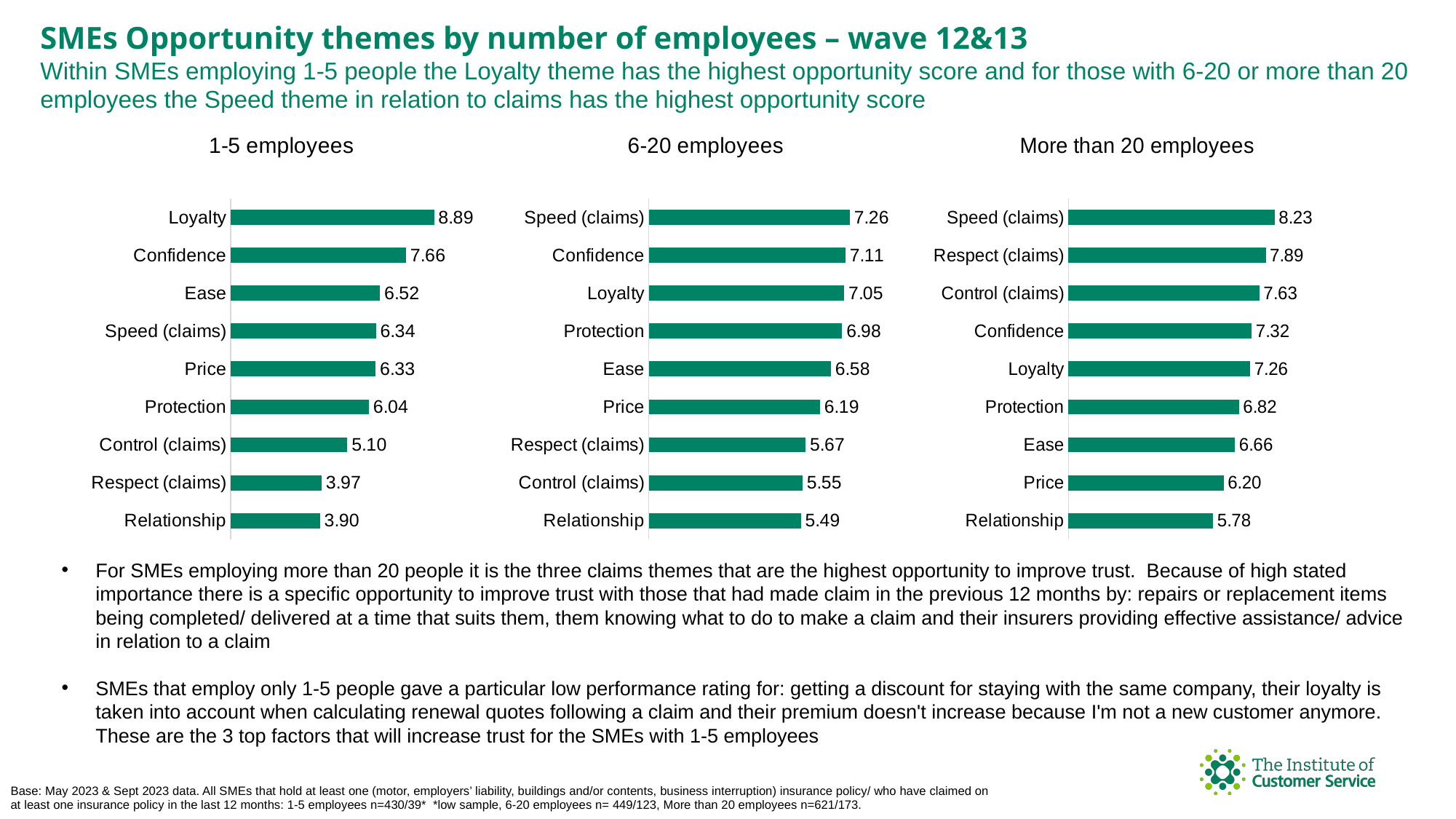
What type of chart is used for the 'More than 20 employees' data? Bar chart In the '6-20 employees' chart, which theme has the highest value? Speed (claims) How many themes are shown in the '1-5 employees' chart? 9 In the '1-5 employees' chart, which is larger, Ease or Protection? Ease In the 'More than 20 employees' chart, which theme has the lowest value? Relationship In the '6-20 employees' chart, which is larger, Price or Respect (claims)? Price In the 'More than 20 employees' chart, what is the value for Respect (claims)? 7.89 In the '1-5 employees' chart, what is the value for Loyalty? 8.89 In the 'More than 20 employees' chart, what is the difference between Speed (claims) and Relationship? 2.45 In the '6-20 employees' chart, what is the value for Protection? 6.98 In the '1-5 employees' chart, what is the difference between Loyalty and Confidence? 1.23 How many charts are shown on the slide? 3